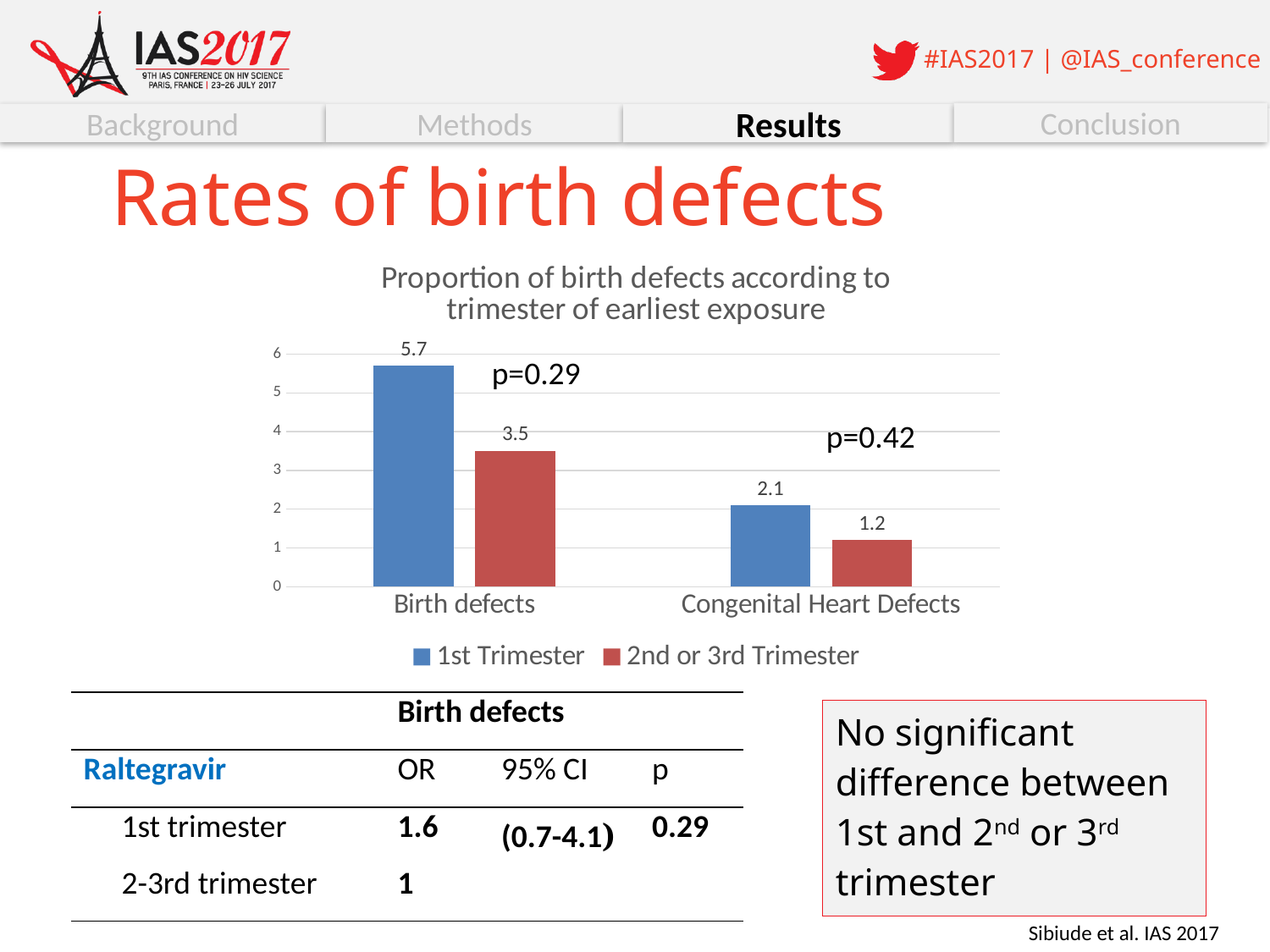
What is the difference between the 1st Trimester and 2nd or 3rd Trimester values for Congenital Heart Defects? 0.9 What is the value for 1st Trimester in the Birth defects category? 5.7 Which bar has the lowest value in the chart? 2nd or 3rd Trimester, Congenital Heart Defects What is the value for 2nd or 3rd Trimester in the Birth defects category? 3.5 How many categories are shown on the x axis of the chart? 2 What is the value for 2nd or 3rd Trimester in the Congenital Heart Defects category? 1.2 Which bar has the highest value in the chart? 1st Trimester, Birth defects How many series does the chart legend list? 2 What kind of chart is shown on the slide? Bar chart What is the value for 1st Trimester in the Congenital Heart Defects category? 2.1 What is the difference between the 1st Trimester and 2nd or 3rd Trimester values for Birth defects? 2.2 Which is larger for Congenital Heart Defects: the 1st Trimester value or the 2nd or 3rd Trimester value? 1st Trimester